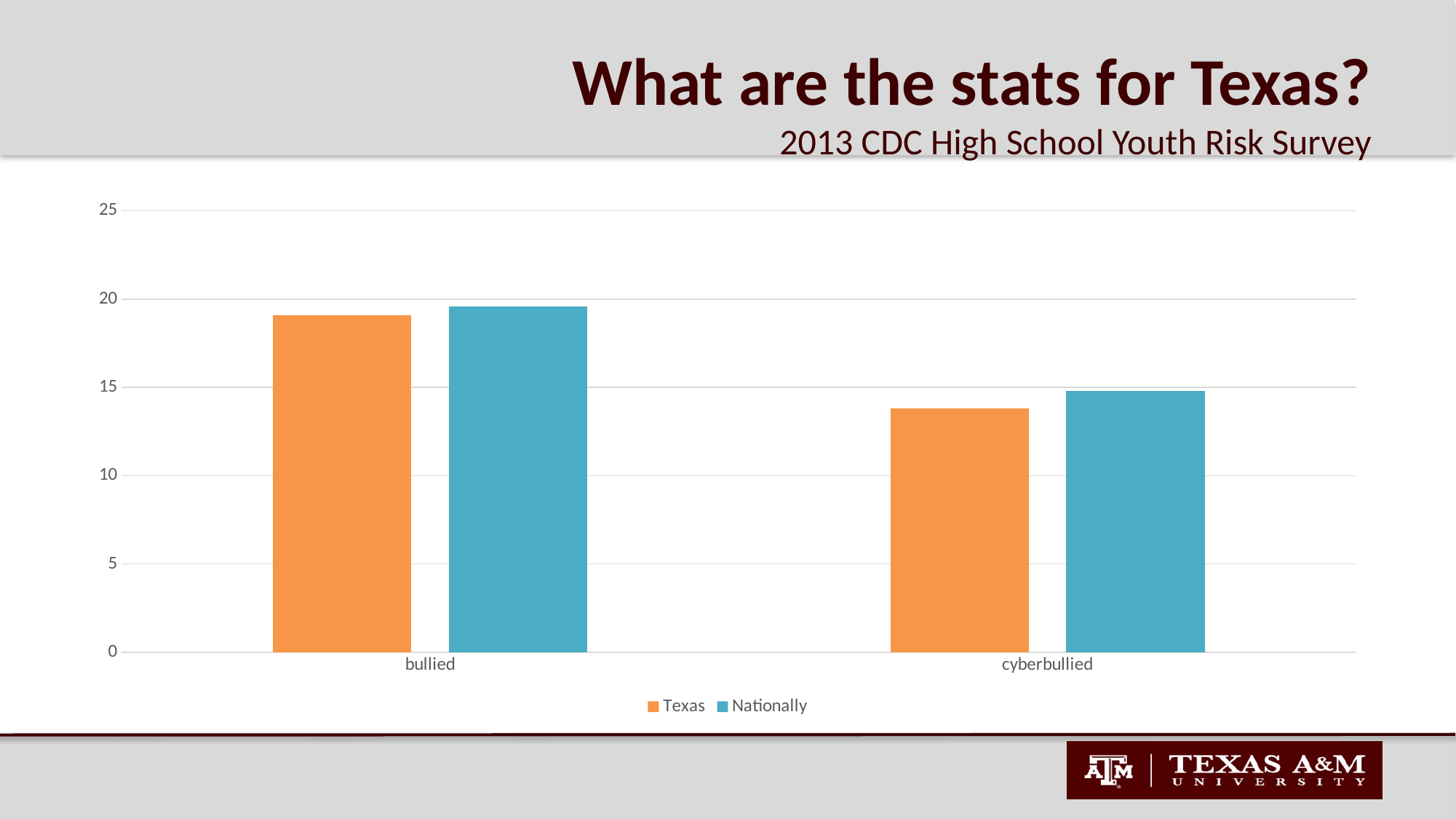
Which bar in the chart is the lowest? Texas, cyberbullied What kind of chart is shown on the slide? bar chart Which series are listed in the chart's legend? Texas and Nationally Is the Texas value for bullied greater or less than 20? less Do the values rise or fall from bullied to cyberbullied? fall How many series does the chart's legend list? 2 For cyberbullied, which is larger: the Texas value or the Nationally value? Nationally How many categories are shown on the x axis of the chart? 2 Is the Texas value for cyberbullied greater or less than 15? less Is the Nationally value for cyberbullied greater or less than 10? greater What colour are the bars for the Texas series? orange